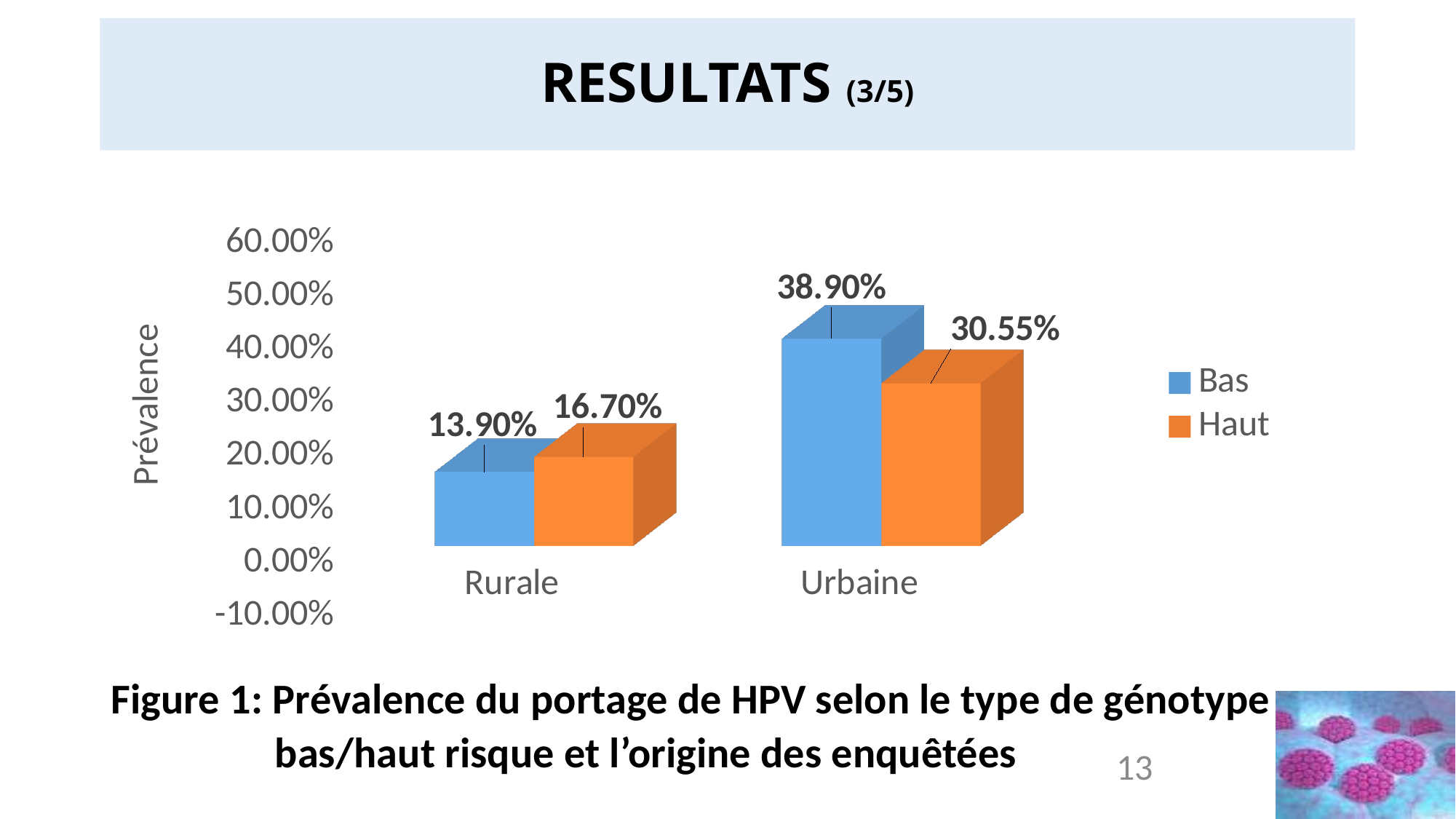
What is the value for Haut in the Urbaine category? 30.55% What kind of chart is shown on the slide? Bar chart Which category has the highest Bas value? Urbaine What is the difference between the Bas and Haut values in the Urbaine category? 8.35% What is the value for Haut in the Rurale category? 16.70% What is the value for Bas in the Rurale category? 13.90% What is the label of the vertical axis? Prévalence How many series does the legend list? 2 In the Rurale category, which is larger, Bas or Haut? Haut Which category has the lowest Haut value? Rurale What is the difference between the Bas values for Urbaine and Rurale? 25.00% How many categories are shown on the x axis? 2